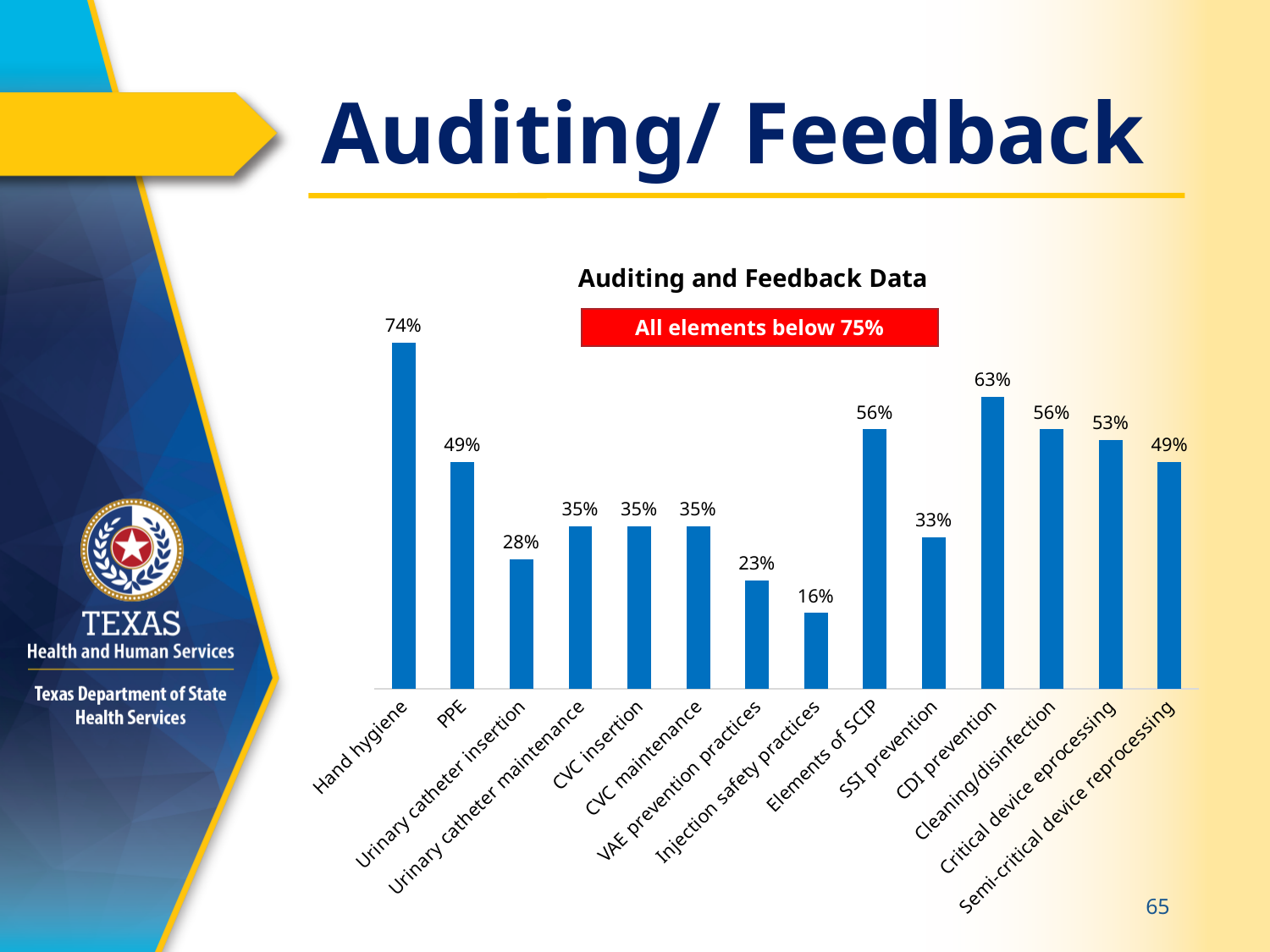
What is the value for Hand hygiene? 74% What does the red box on the chart say? All elements below 75% Which is larger, the value for Elements of SCIP or the value for Critical device eprocessing? Elements of SCIP Which category has the lowest value? Injection safety practices What is the value for CDI prevention? 63% What is the value for Injection safety practices? 16% What kind of chart is shown on the slide? Bar chart What is the difference between the values for Hand hygiene and PPE? 25% How many categories are shown in the chart? 14 Which category has the highest value? Hand hygiene What is the value for SSI prevention? 33% What is the difference between the values for CDI prevention and SSI prevention? 30%